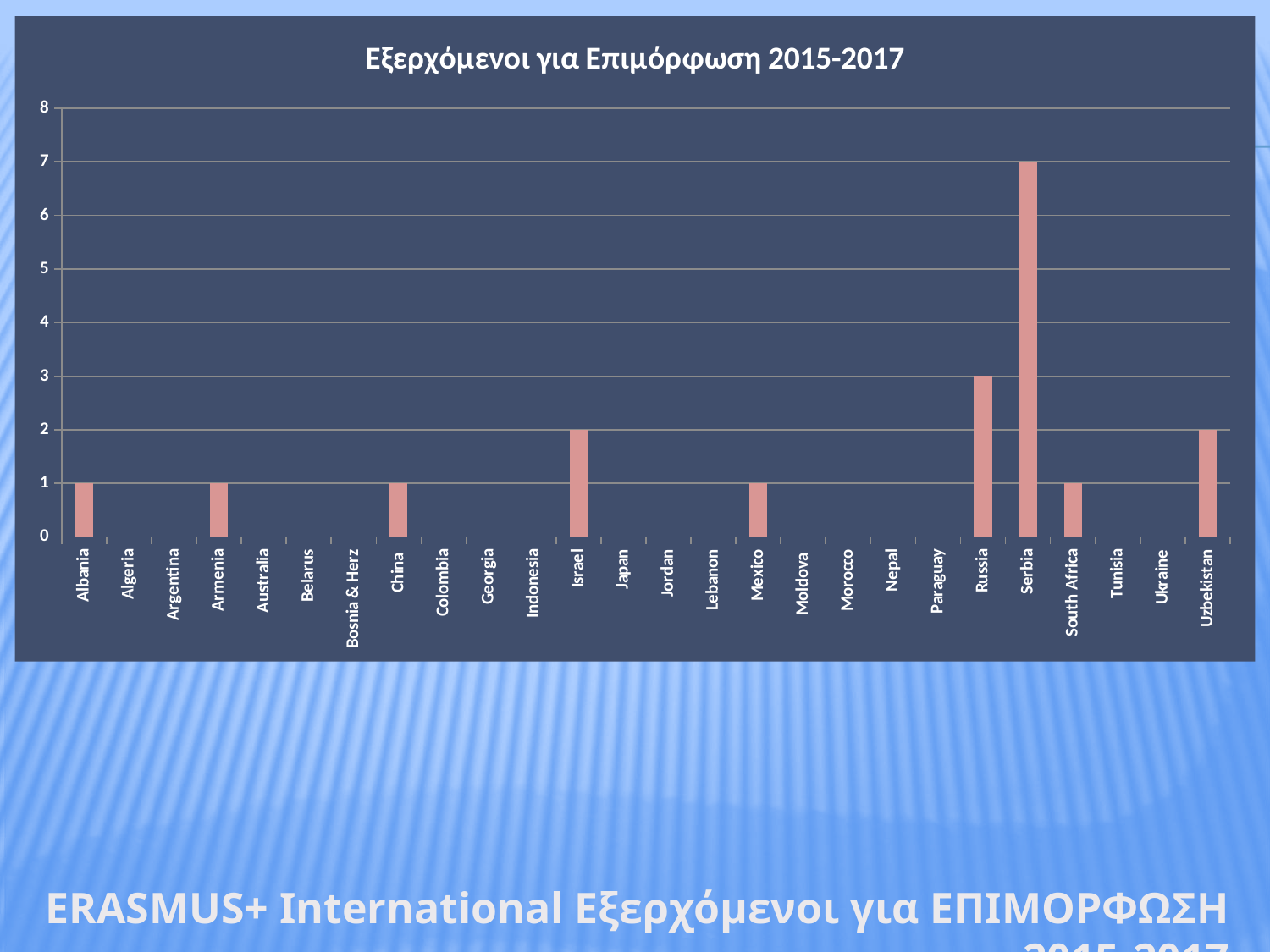
What is the title of the chart? Εξερχόμενοι για Επιμόρφωση 2015-2017 What is the value for Uzbekistan? 2 What is the value for Israel? 2 Which country has the highest value in the chart? Serbia What is the value for Serbia? 7 What is the value for Russia? 3 How many countries are listed on the x axis of the chart? 26 What kind of chart is shown on the slide? bar chart What is the difference between the values for Serbia and Russia? 4 Which is larger, the value for Russia or the value for Israel? Russia What is the value for Albania? 1 Is the value for Serbia greater or less than 5? greater